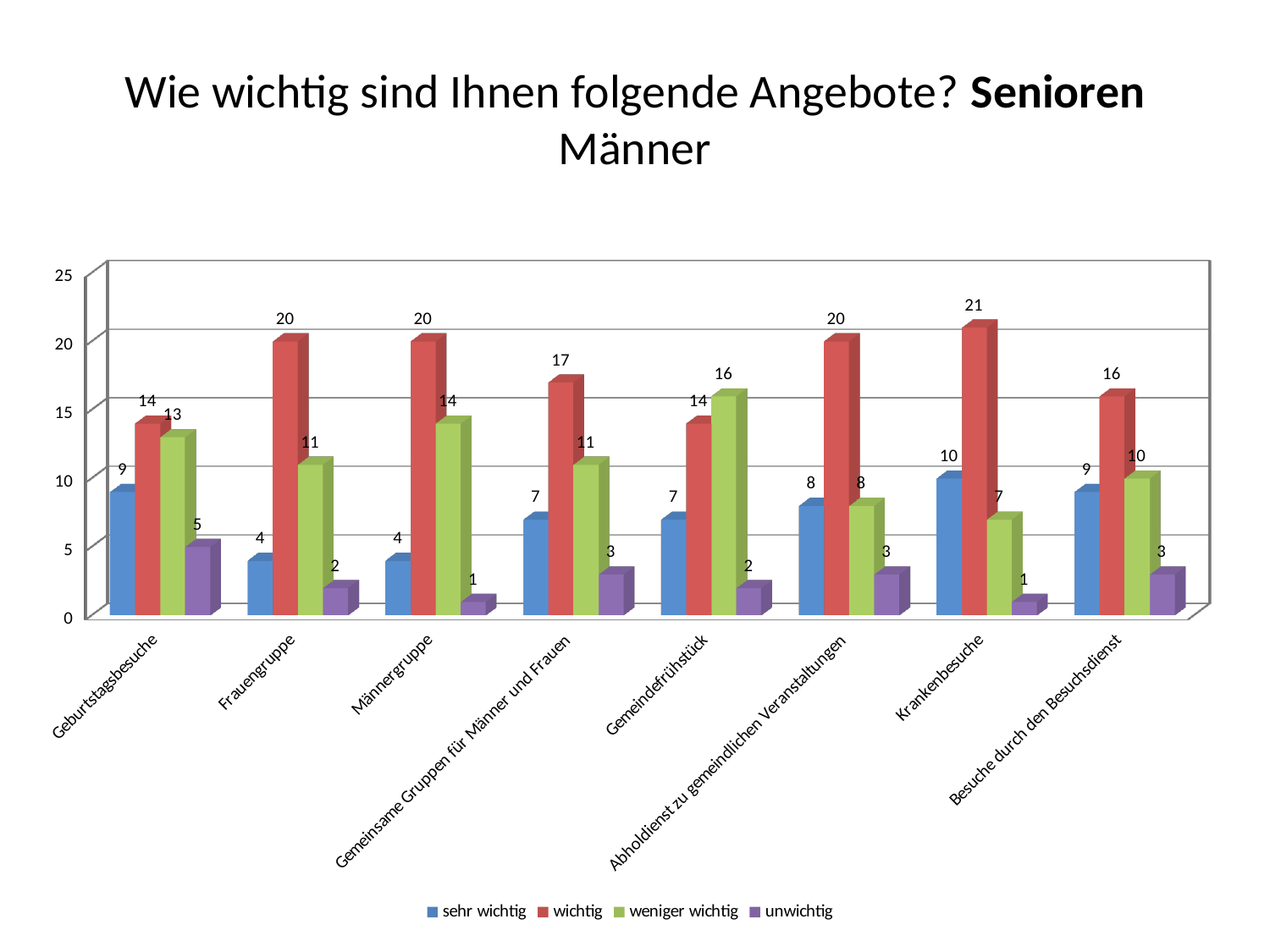
How many series does the legend list? 4 Which is larger for Gemeindefrühstück: the "wichtig" value or the "weniger wichtig" value? weniger wichtig Which category has the highest value for "wichtig"? Krankenbesuche Which category has the lowest value for "sehr wichtig"? Frauengruppe and Männergruppe (both 4) Which series is shown in red in the legend? wichtig What is the value for "wichtig" for Krankenbesuche? 21 What is the value for "sehr wichtig" for Geburtstagsbesuche? 9 How many categories are shown on the x axis? 8 What is the value for "weniger wichtig" for Gemeindefrühstück? 16 What kind of chart is shown on the slide? Bar chart What is the difference between the "wichtig" value for Frauengruppe and the "sehr wichtig" value for Frauengruppe? 16 What is the value for "unwichtig" for Männergruppe? 1